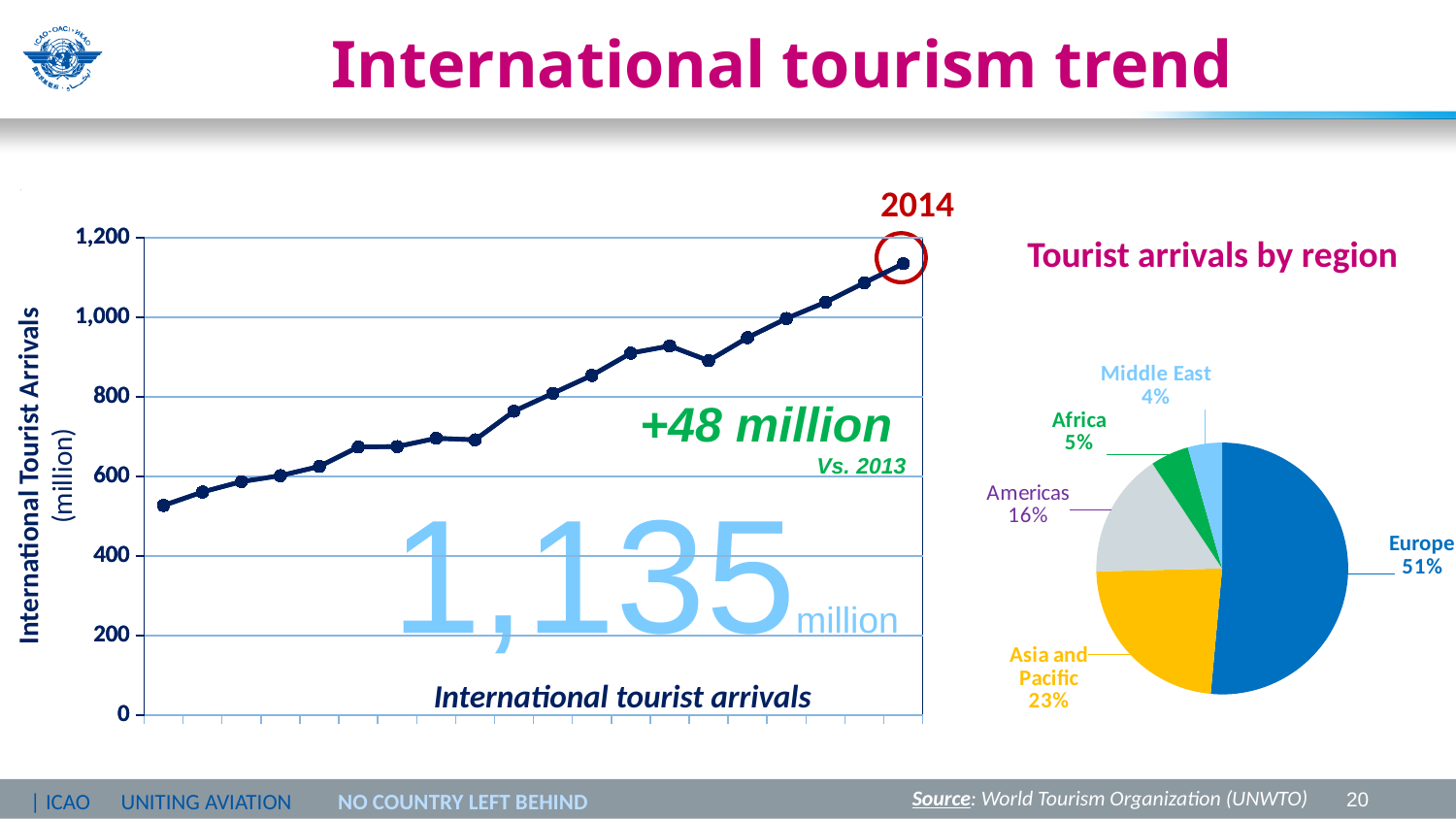
On the pie chart 'Tourist arrivals by region', what is the share for Asia and Pacific? 23% On the line chart on the left, what is the value of international tourist arrivals in 2014? 1,135 million On the pie chart 'Tourist arrivals by region', which has the larger share, Americas or Africa? Americas On the pie chart 'Tourist arrivals by region', which region has the smallest share of tourist arrivals? Middle East On the pie chart 'Tourist arrivals by region', how many regions are shown? 5 On the line chart on the left, do international tourist arrivals generally rise or fall over time along the x axis? Rise On the line chart on the left, by how much did international tourist arrivals in 2014 increase compared with 2013, according to the annotation? +48 million On the pie chart 'Tourist arrivals by region', which region has the largest share of tourist arrivals? Europe On the line chart on the left, is the value of the first (leftmost) point greater or less than 600? less On the pie chart 'Tourist arrivals by region', how many percentage points larger is Europe's share than the share of Asia and Pacific? 28 percentage points What kind of chart is the chart on the left of the slide showing international tourist arrivals? Line chart On the pie chart 'Tourist arrivals by region', what share of tourist arrivals does Europe account for? 51%